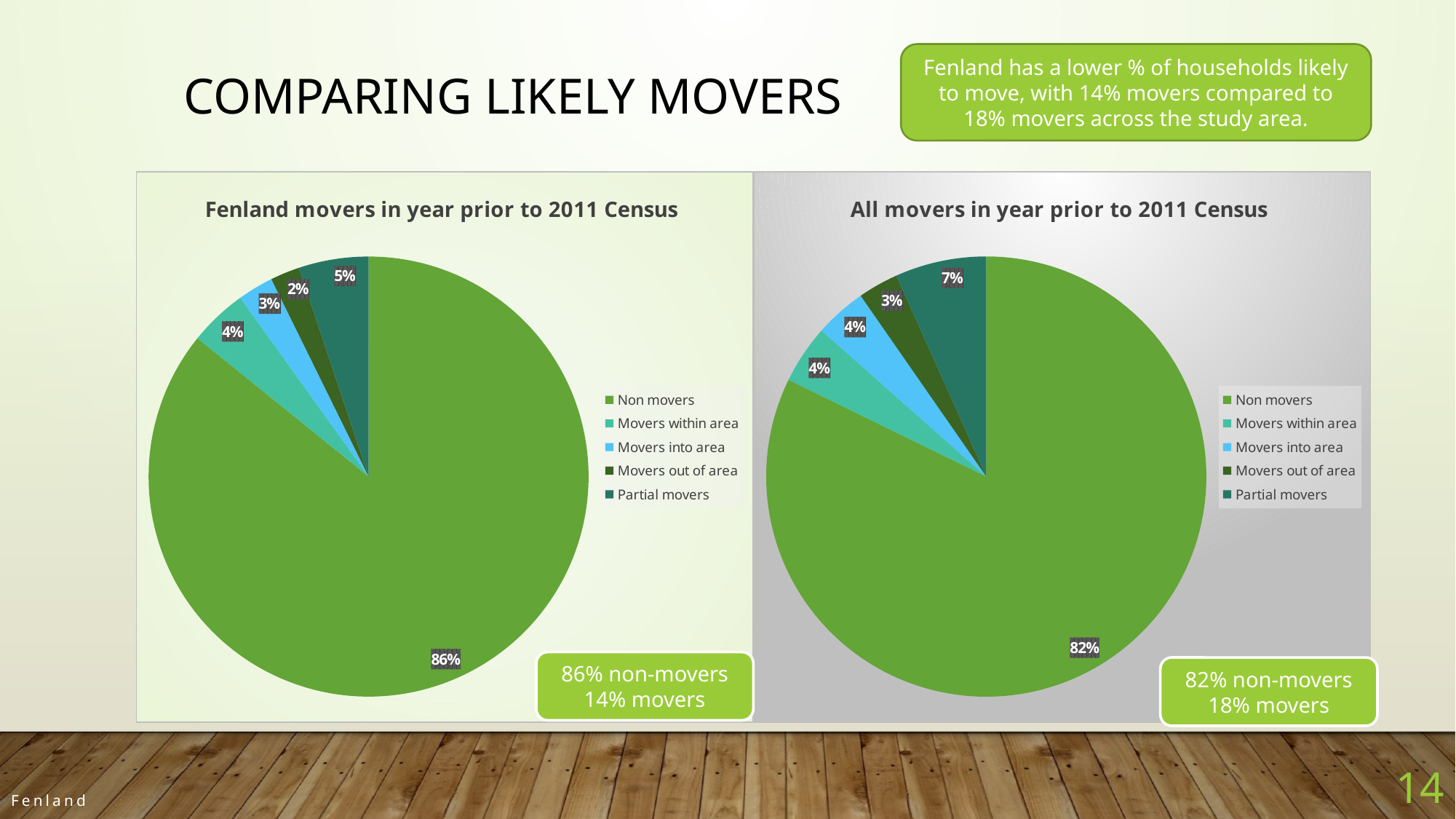
In the 'Fenland movers in year prior to 2011 Census' chart, what share of the pie is Non movers? 86% In the 'Fenland movers in year prior to 2011 Census' chart, which category has the smallest slice? Movers out of area What is the difference between the Partial movers share in the 'All movers' chart and the Partial movers share in the 'Fenland movers' chart? 2% In the 'All movers in year prior to 2011 Census' chart, which category has the largest slice? Non movers In the 'Fenland movers in year prior to 2011 Census' chart, what is the value for Partial movers? 5% In the 'All movers in year prior to 2011 Census' chart, what is the value for Movers out of area? 3% Which is larger: Movers within area in the 'Fenland movers' chart or Partial movers in the 'Fenland movers' chart? Partial movers In the 'All movers in year prior to 2011 Census' chart, what is the value for Partial movers? 7% What type of chart is 'All movers in year prior to 2011 Census'? Pie chart How many categories does the legend of the 'Fenland movers in year prior to 2011 Census' chart list? 5 In the 'All movers in year prior to 2011 Census' chart, what share of the pie is Non movers? 82% In the 'Fenland movers in year prior to 2011 Census' chart, what is the value for Movers out of area? 2%